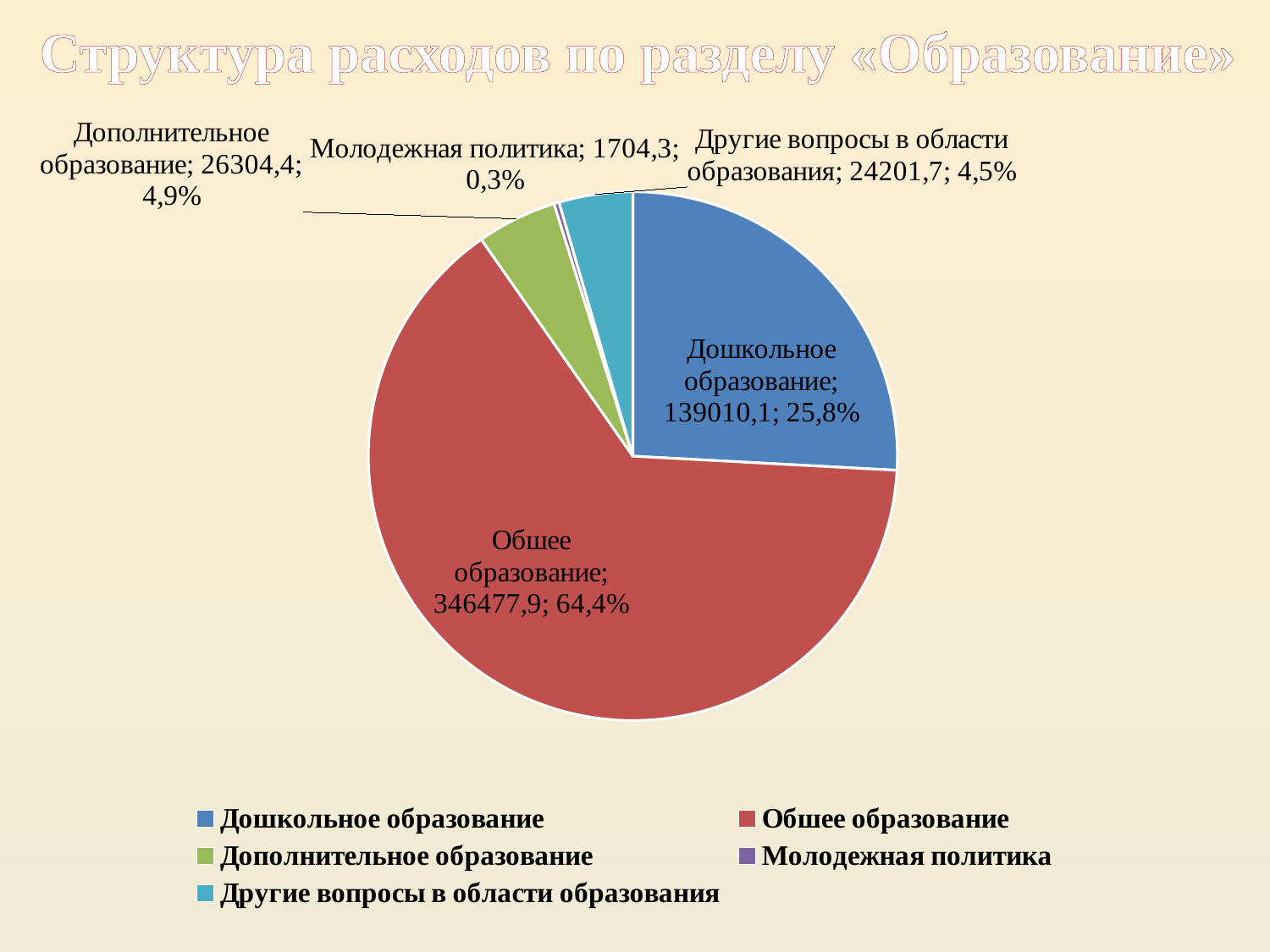
What is the value for Молодежная политика? 1704,3 What share of the pie does Общее образование take? 64,4% What is the value for Общее образование? 346477,9 Which is larger, Дополнительное образование or Другие вопросы в области образования? Дополнительное образование What share of the pie does Дополнительное образование take? 4,9% Which category has the largest slice? Общее образование What is the value for Дошкольное образование? 139010,1 How many categories does the pie chart have? 5 What kind of chart is shown on the slide? Pie chart What is the value for Другие вопросы в области образования? 24201,7 Which category has the smallest slice? Молодежная политика What is the difference between the values for Общее образование and Дошкольное образование? 207467,8